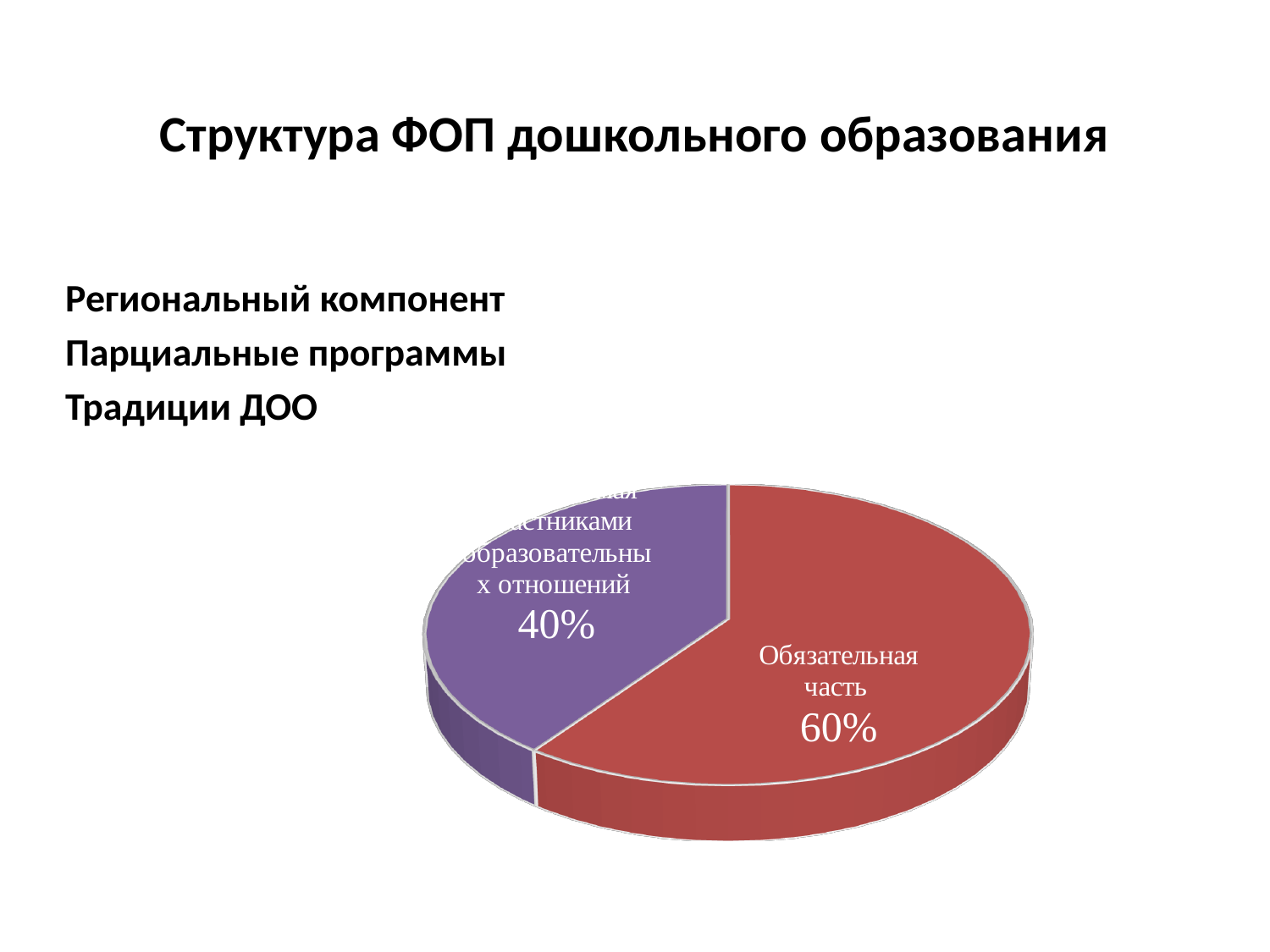
What is the difference in percentage points between the "Обязательная часть" slice and the purple slice? 20 Is the share of "Обязательная часть" greater or less than 50%? greater What share of the pie does the "Обязательная часть" slice represent? 60% What is the total of the two percentages shown on the pie chart? 100% What is the title of the slide containing the pie chart? Структура ФОП дошкольного образования What colour is the "Обязательная часть" slice? red How many slices does the pie chart have? 2 Which slice of the pie chart is the largest? Обязательная часть Which is larger: the "Обязательная часть" slice or the purple slice? Обязательная часть What percentage is shown on the purple slice of the pie chart? 40% What kind of chart is shown on the slide? pie chart